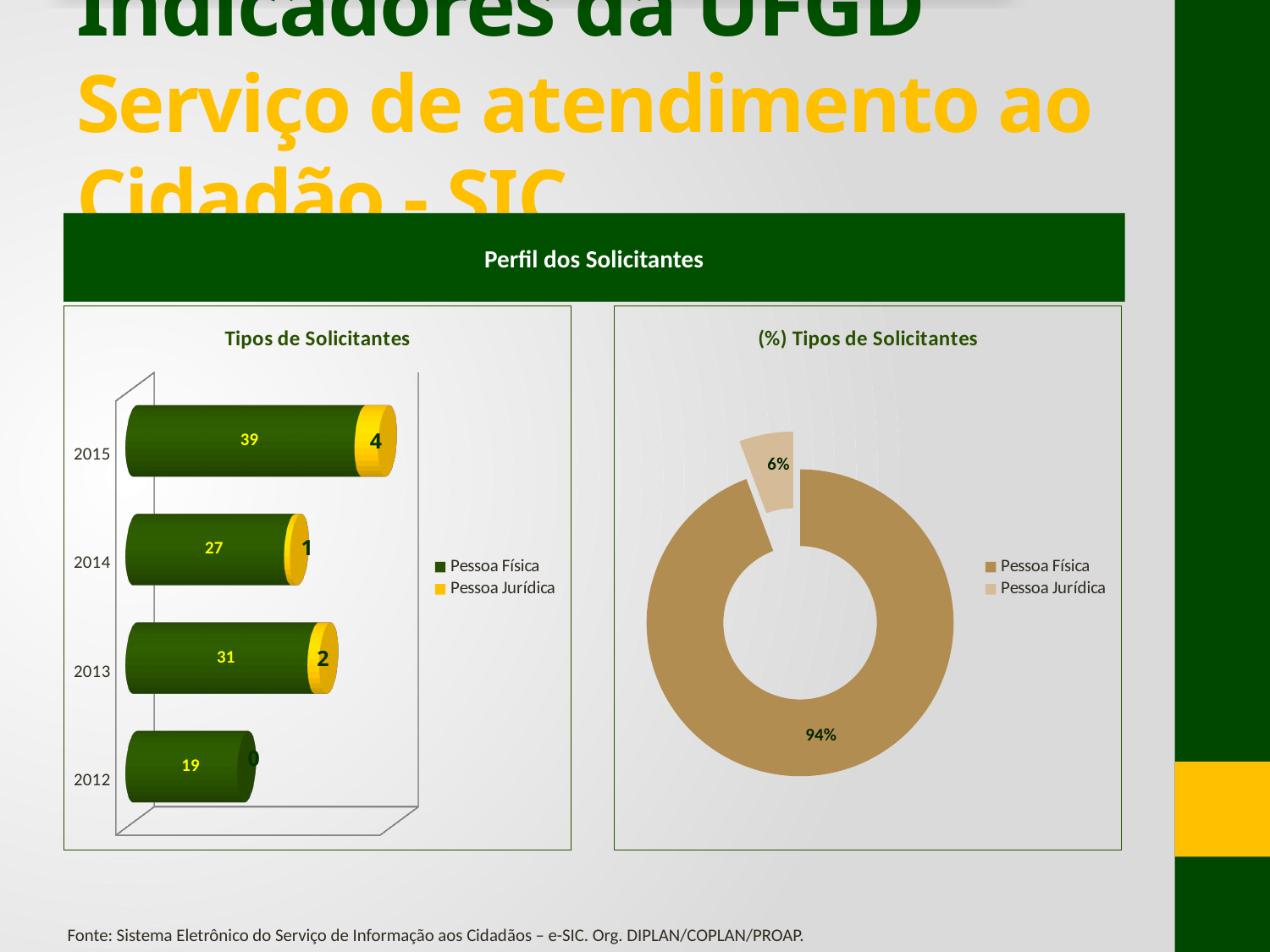
How many series does the legend of the 'Tipos de Solicitantes' chart list? 2 In the 'Tipos de Solicitantes' chart, what is the value for Pessoa Física in 2012? 19 In the 'Tipos de Solicitantes' chart, what is the value for Pessoa Jurídica in 2013? 2 In the 'Tipos de Solicitantes' chart, what is the value for Pessoa Física in 2015? 39 In the 'Tipos de Solicitantes' chart, which year has the lowest value for Pessoa Física? 2012 What kind of chart is the '(%) Tipos de Solicitantes' chart? Doughnut chart In the 'Tipos de Solicitantes' chart, which year has the highest value for Pessoa Física? 2015 In the '(%) Tipos de Solicitantes' chart, what share does Pessoa Jurídica have? 6% In the 'Tipos de Solicitantes' chart, what is the total of the stacked bar for 2015? 43 In the 'Tipos de Solicitantes' chart, what is the difference between the Pessoa Física values for 2015 and 2014? 12 In the 'Tipos de Solicitantes' chart, is the Pessoa Física value for 2013 larger or smaller than the value for 2014? larger How many years are shown in the 'Tipos de Solicitantes' chart? 4